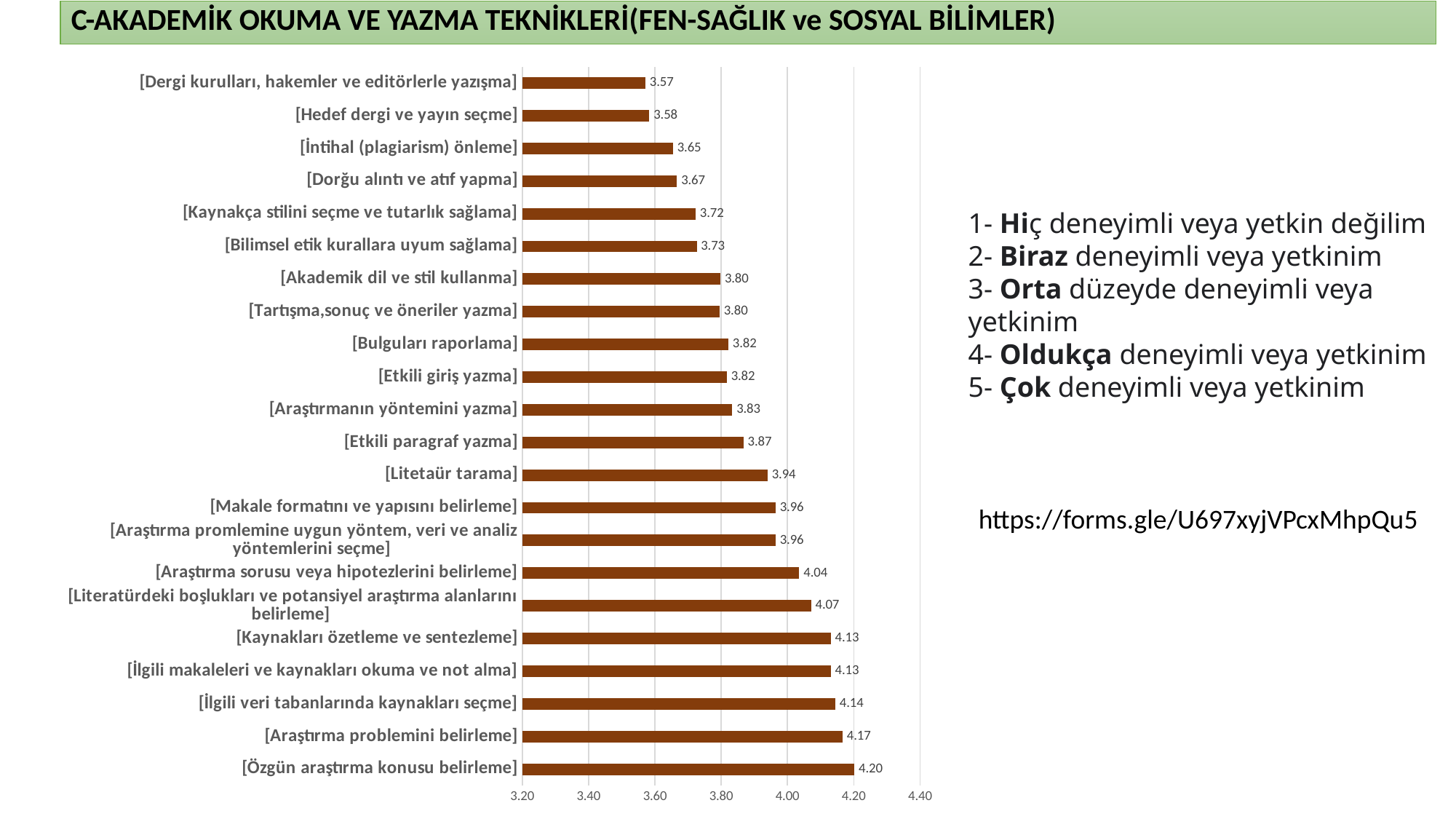
What is the value for [Özgün araştırma konusu belirleme]? 4.20 Which category has the highest value? [Özgün araştırma konusu belirleme] What is the maximum value shown on the horizontal axis? 4.40 Which is larger: the value for [Etkili paragraf yazma] or the value for [Bilimsel etik kurallara uyum sağlama]? [Etkili paragraf yazma] Which category has the lowest value? [Dergi kurulları, hakemler ve editörlerle yazışma] What is the difference between the values for [Araştırma problemini belirleme] and [Hedef dergi ve yayın seçme]? 0.59 What is the value for [Kaynakları özetleme ve sentezleme]? 4.13 What is the value for [Litetaür tarama]? 3.94 How many categories are shown in the chart? 22 Is the value for [Araştırma sorusu veya hipotezlerini belirleme] greater or less than 4.00? greater What kind of chart is shown on the slide? bar chart What is the value for [İntihal (plagiarism) önleme]? 3.65